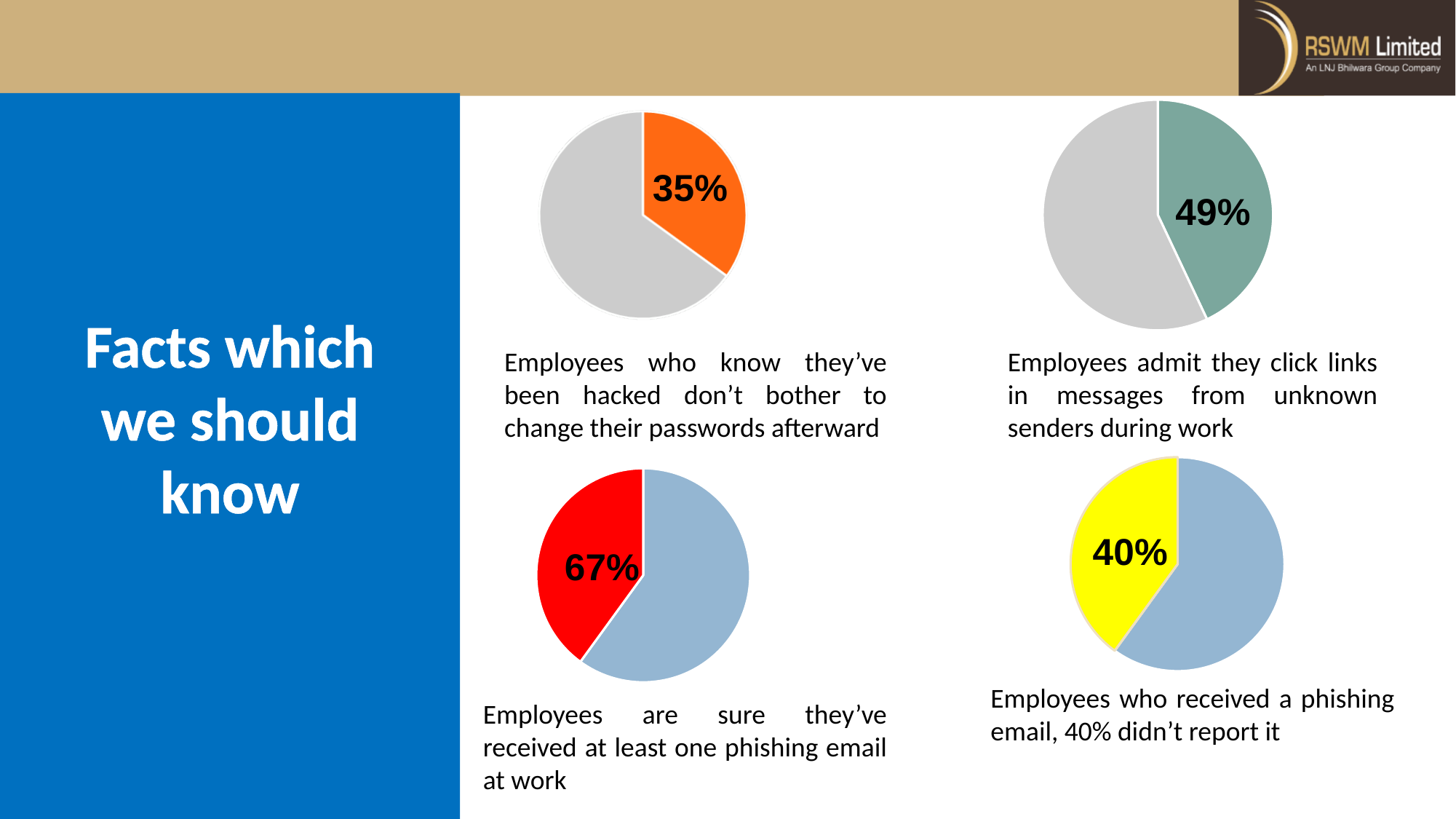
In the top-right pie chart, what percentage of employees admit they click links in messages from unknown senders during work? 49% What kind of chart is used for each of the four statistics on the slide? Pie chart In the bottom-right pie chart, what percentage of employees who received a phishing email didn't report it? 40% Which is larger: the labelled slice in the top-right pie chart or the labelled slice in the bottom-right pie chart? The top-right chart (49%) What colour is the labelled 67% slice in the bottom-left pie chart? Red Which of the four pie charts on the slide shows the highest labelled percentage? The bottom-left chart (67%) What is the difference between the labelled percentage in the bottom-left pie chart and the labelled percentage in the top-left pie chart? 32% In the top-left pie chart, what percentage of employees who know they've been hacked don't bother to change their passwords afterward? 35% In the bottom-left pie chart, what percentage of employees are sure they've received at least one phishing email at work? 67% In the top-left pie chart, is the labelled slice greater or less than 50%? less How many pie charts are shown on the slide? 4 Which of the four pie charts on the slide shows the lowest labelled percentage? The top-left chart (35%)